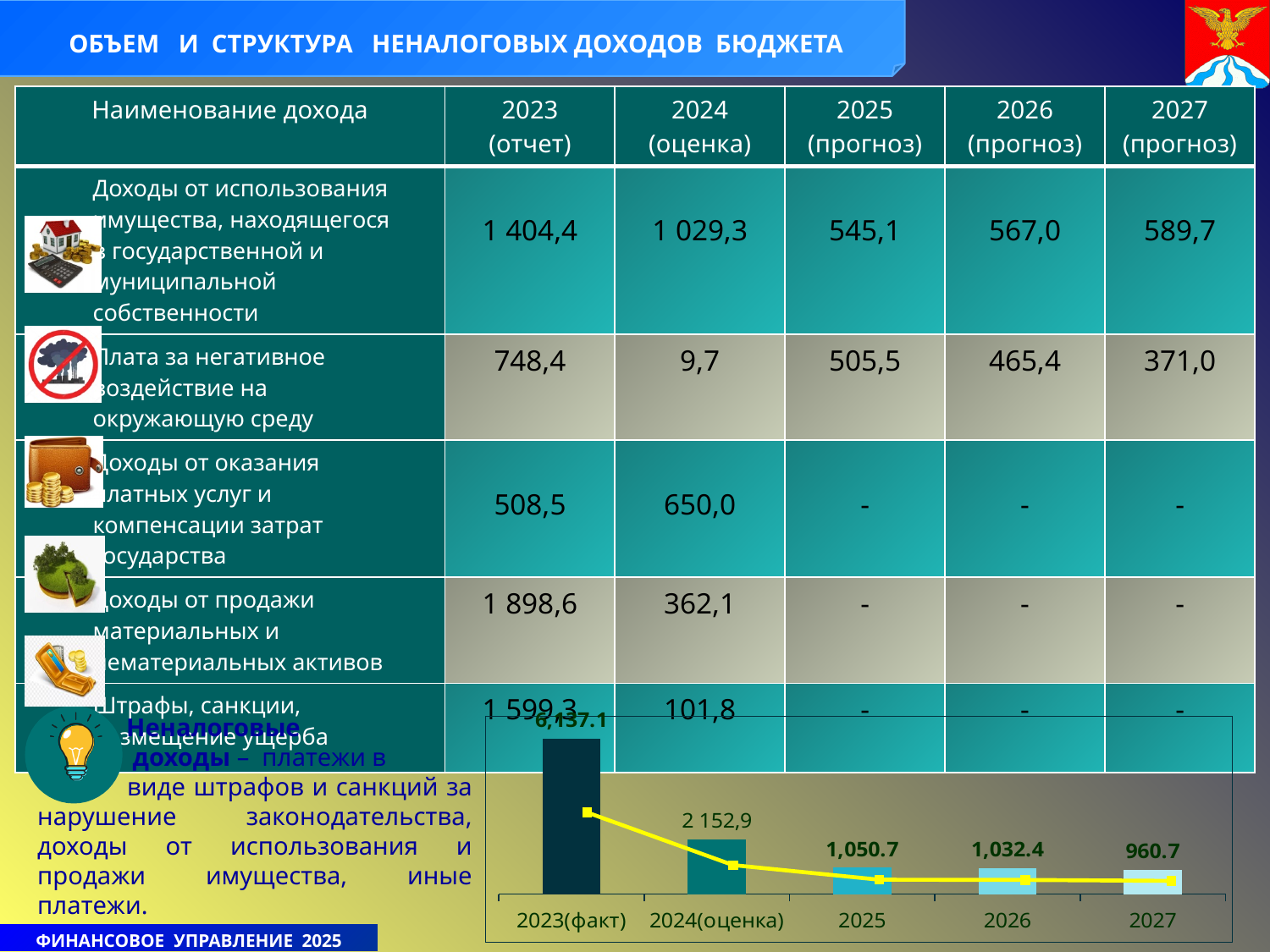
What kind of chart is shown at the bottom of the slide? Bar chart with a line overlay In the chart at the bottom of the slide, what is the value for 2027? 960.7 In the chart at the bottom of the slide, what is the value for 2025? 1,050.7 In the chart at the bottom of the slide, which year has the highest value? 2023(факт) In the chart at the bottom of the slide, what is the difference between the values for 2025 and 2026? 18.3 In the chart at the bottom of the slide, which is larger: the value for 2024(оценка) or the value for 2025? 2024(оценка) In the chart at the bottom of the slide, what is the difference between the values for 2026 and 2027? 71.7 In the chart at the bottom of the slide, do the values rise or fall from 2023(факт) to 2027? Fall How many categories (years) are shown on the x axis of the chart at the bottom of the slide? 5 In the chart at the bottom of the slide, which year has the lowest value? 2027 In the chart at the bottom of the slide, what is the value for 2024(оценка)? 2 152,9 In the chart at the bottom of the slide, what is the value for 2026? 1,032.4